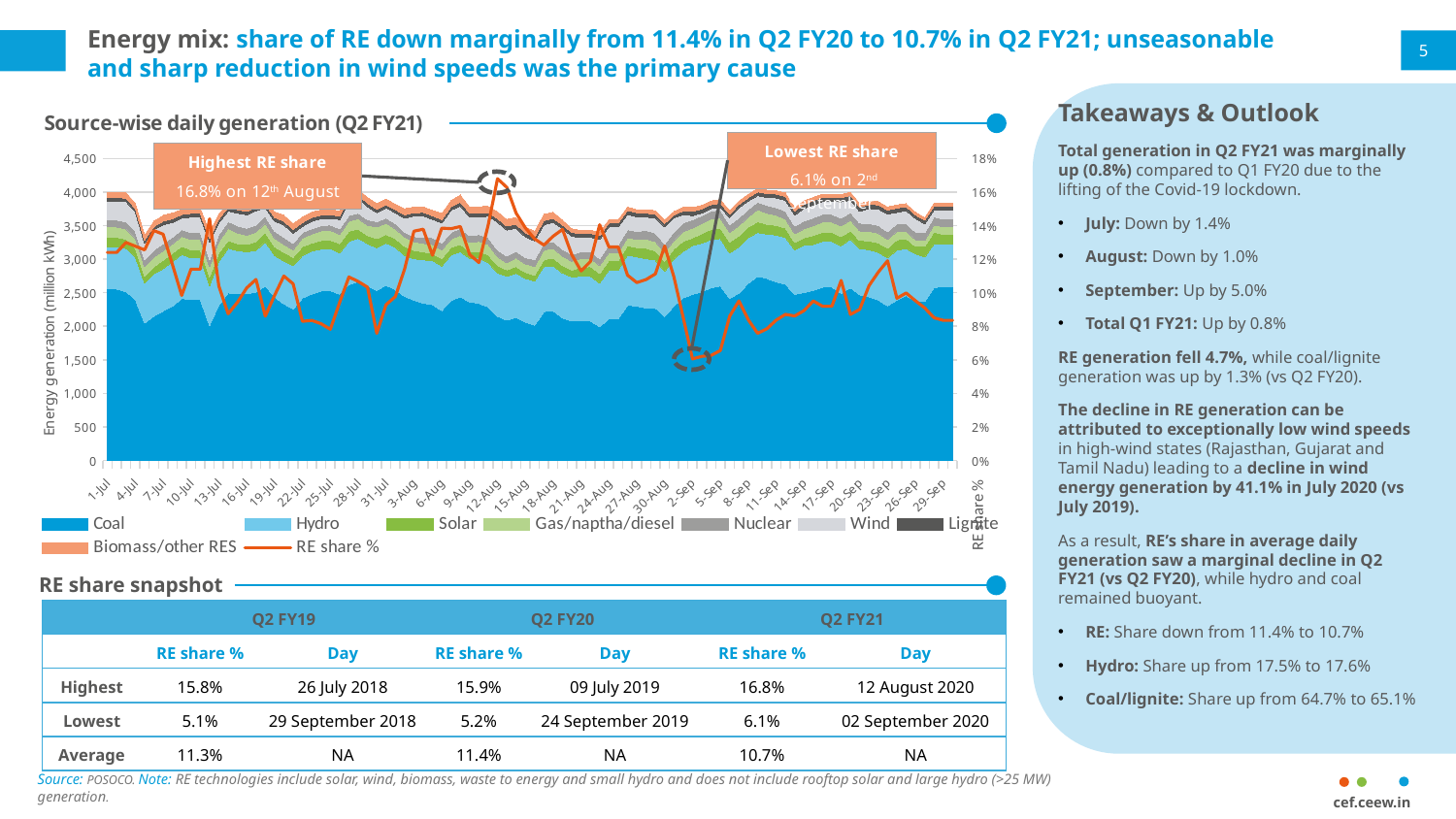
In the 'Source-wise daily generation (Q2 FY21)' chart, is the total stacked generation on 1-Jul greater or less than 3,500 million kWh? greater In the 'Source-wise daily generation (Q2 FY21)' chart, which series is plotted as a line rather than a stacked area? RE share % In the 'Source-wise daily generation (Q2 FY21)' chart, on which date did the lowest RE share occur? 2nd September In the 'Source-wise daily generation (Q2 FY21)' chart, on which date did the highest RE share occur? 12th August What kind of chart is 'Source-wise daily generation (Q2 FY21)'? Stacked area chart with a line In the 'Source-wise daily generation (Q2 FY21)' chart, what is the lowest RE share value annotated? 6.1% What is the label of the left vertical axis in the 'Source-wise daily generation (Q2 FY21)' chart? Energy generation (million kWh) How many series does the legend of the 'Source-wise daily generation (Q2 FY21)' chart list? 9 In the 'Source-wise daily generation (Q2 FY21)' chart, is the coal generation on 1-Jul greater or less than 2,000 million kWh? greater In the 'Source-wise daily generation (Q2 FY21)' chart, what is the difference between the highest and lowest annotated RE share values? 10.7 percentage points In the 'Source-wise daily generation (Q2 FY21)' chart, what is the highest RE share value annotated? 16.8% In the 'Source-wise daily generation (Q2 FY21)' chart, is the highest annotated RE share (16.8%) greater or less than the lowest annotated RE share (6.1%)? greater